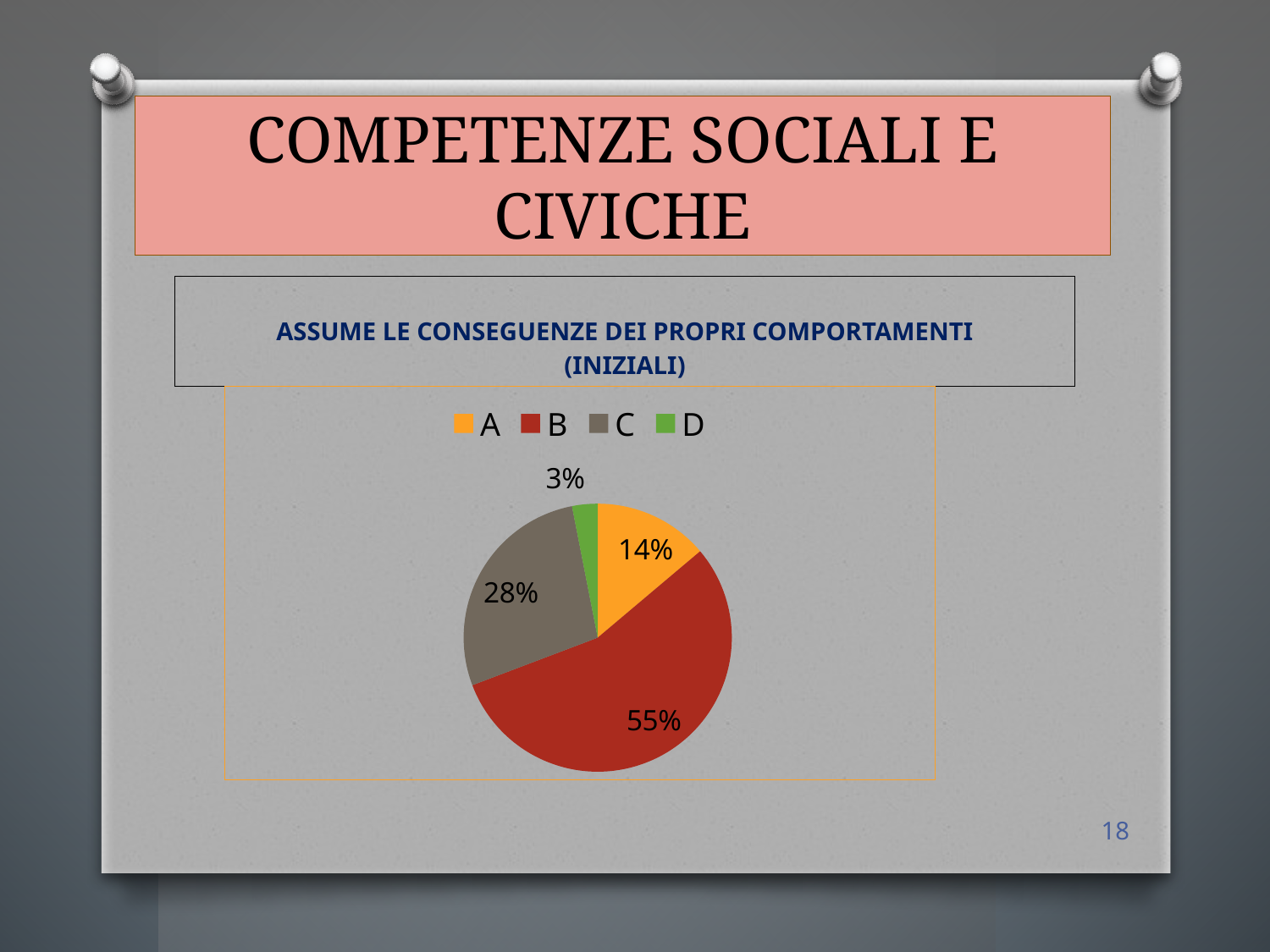
How many categories does the legend list? 4 Which category has the largest slice of the pie? B Which is larger, the share for A or the share for C? C What is the share for category A? 14% What is the difference in percentage points between category B and category C? 27 What is the share for category D? 3% What is the share for category C? 28% What is the title of the chart? ASSUME LE CONSEGUENZE DEI PROPRI COMPORTAMENTI (INIZIALI) What is the share for category B? 55% What colour is the slice for category B? red What kind of chart is shown on the slide? pie chart Which category has the smallest slice of the pie? D